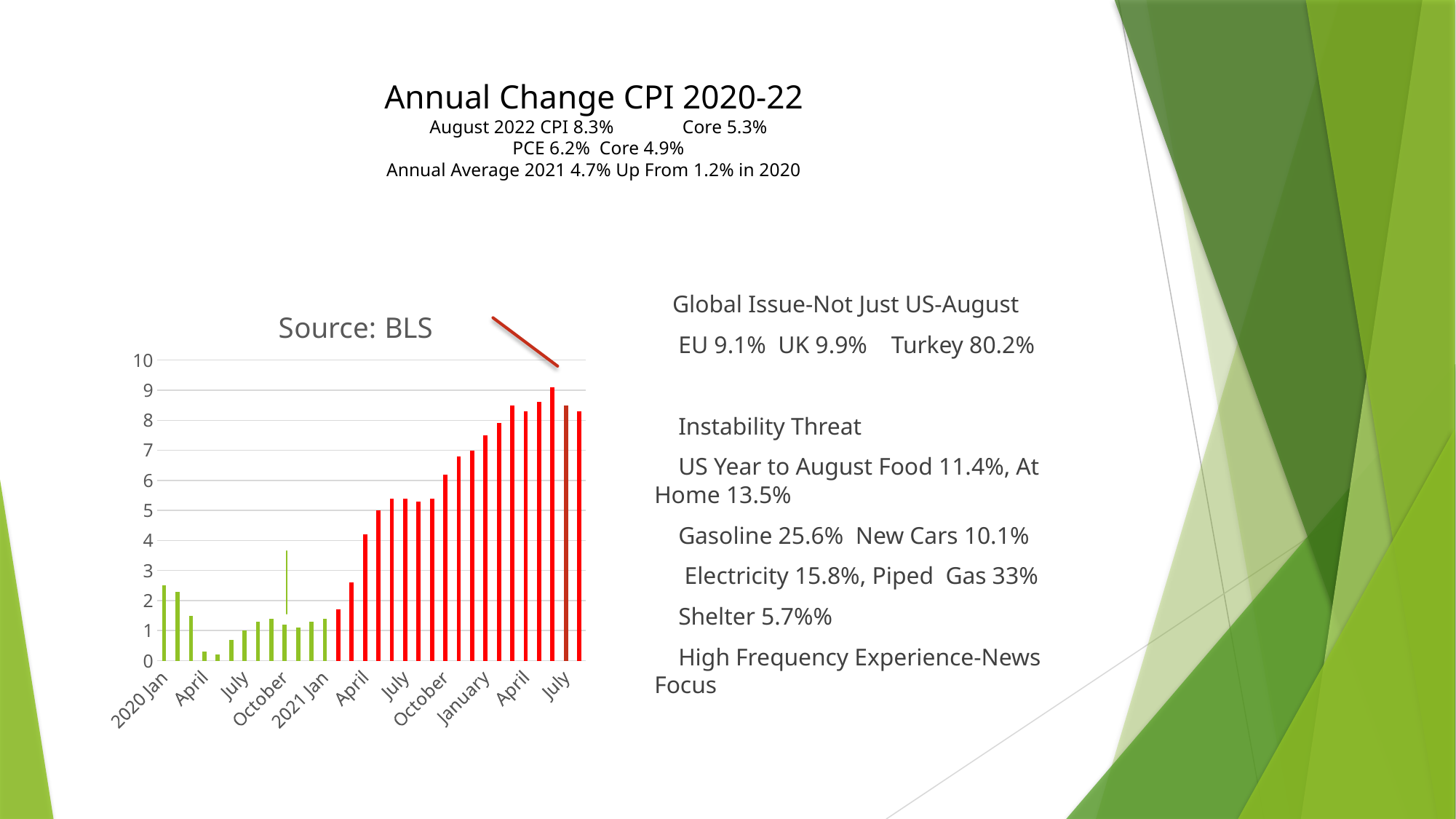
Is the value for July 2022 greater or less than 8? greater Is the value for October 2021 greater or less than 5? greater Do the values generally rise or fall from 2021 Jan to July 2022? rise What is the highest value shown on the vertical axis? 10 Is the value for 2021 Jan greater or less than 2? less What kind of chart is shown on the slide? bar chart Which is larger, the value for July 2020 or the value for July 2022? July 2022 What is the title shown above the chart? Source: BLS Which is larger, the value for 2020 Jan or the value for 2021 Jan? 2020 Jan